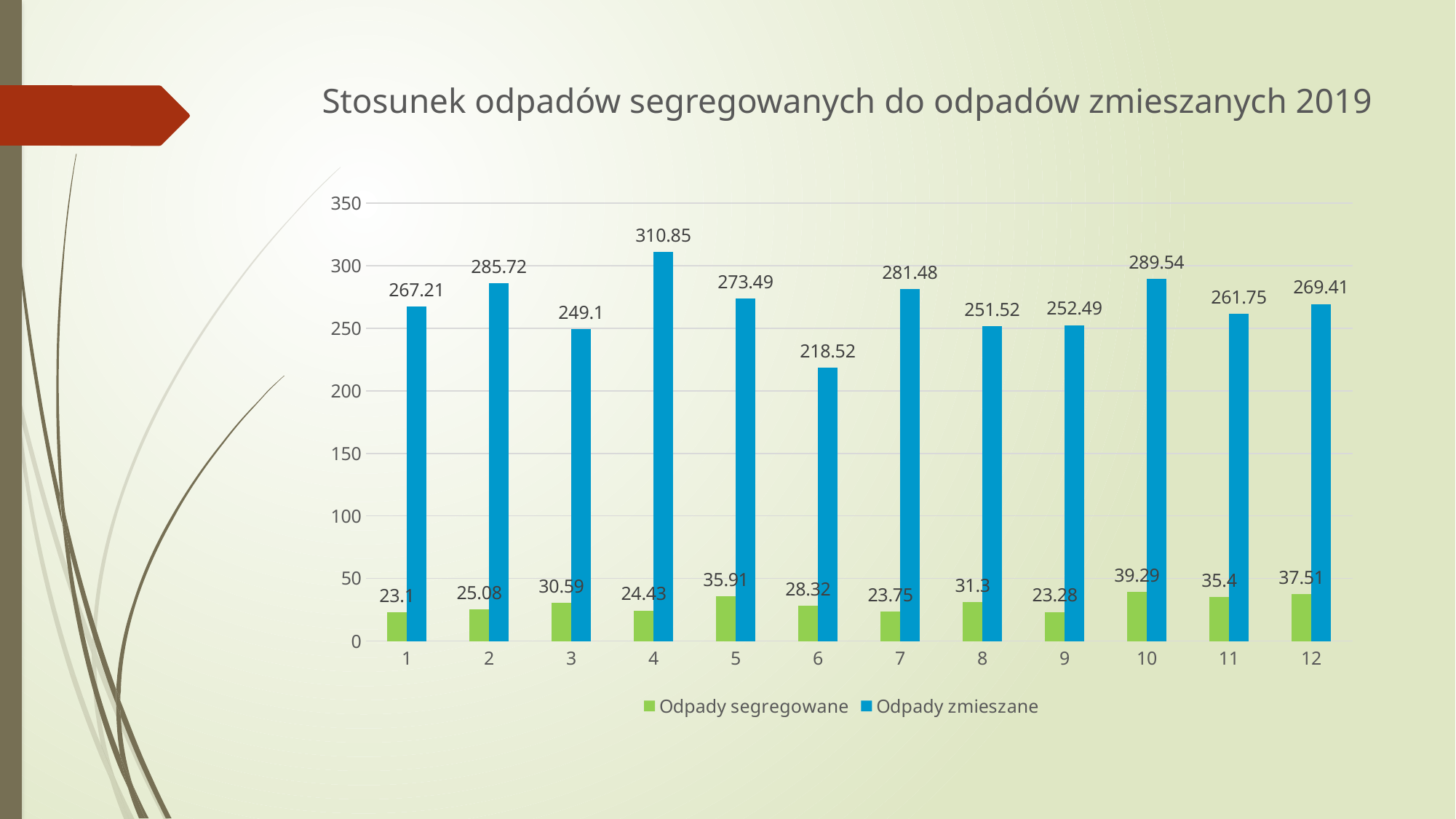
What is the difference between the highest and lowest Odpady zmieszane values? 92.33 What is the difference between Odpady zmieszane and Odpady segregowane for category 4? 286.42 What is the value of Odpady zmieszane for category 4? 310.85 Which category has the highest value for Odpady zmieszane? 4 How many series does the legend list? 2 How many categories are shown on the x axis? 12 Which category has the larger Odpady zmieszane value, 2 or 3? 2 Is the Odpady zmieszane value for category 6 greater or less than 250? less What is the value of Odpady segregowane for category 6? 28.32 Which category has the lowest value for Odpady zmieszane? 6 Which category has the lowest value for Odpady segregowane? 1 What is the value of Odpady segregowane for category 10? 39.29